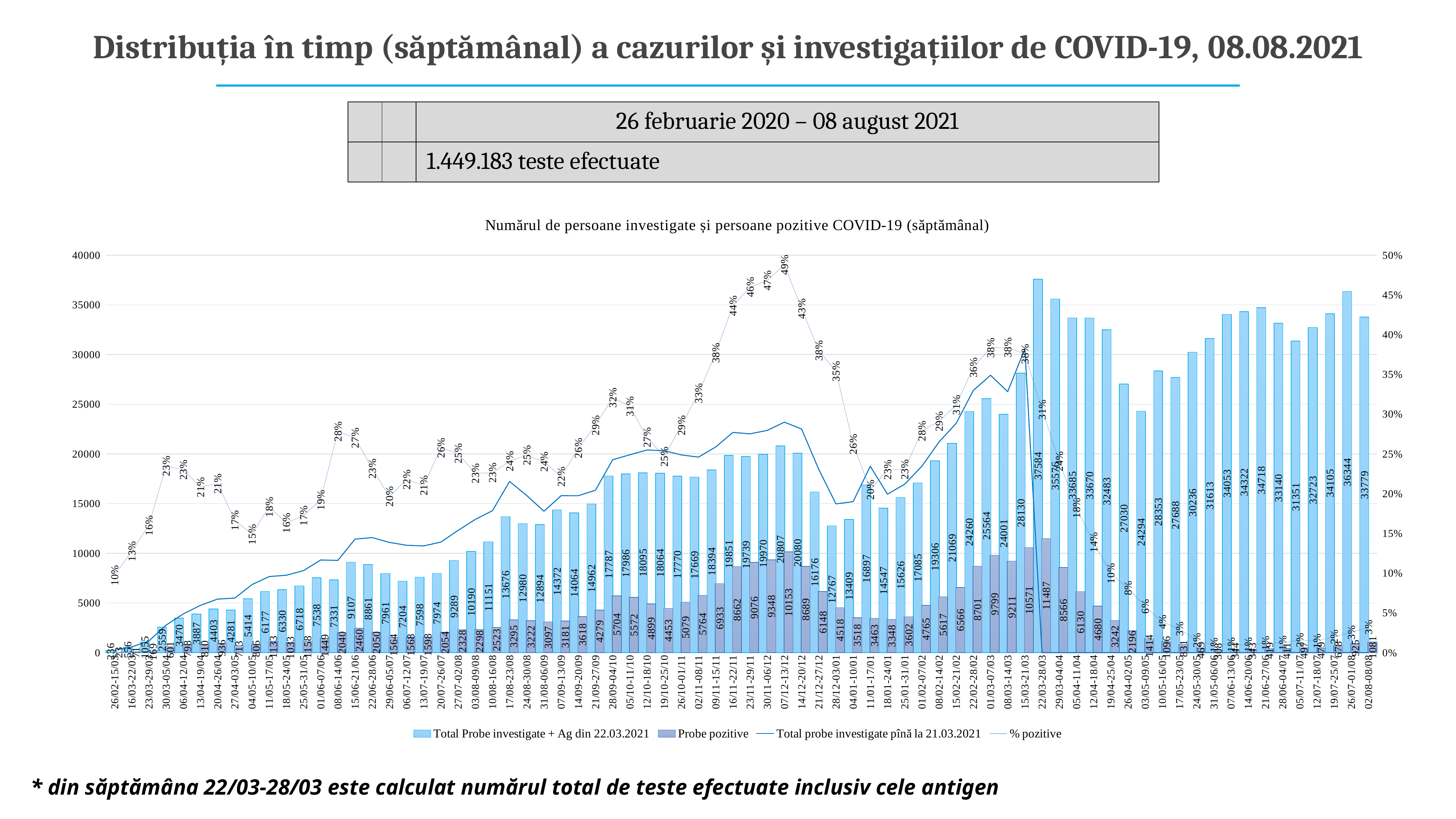
What is the highest value of '% pozitive' shown on the chart? 49% Which week has the highest total number of probes investigated? 22/03-28/03 What is the difference between the total probes investigated in the week 22/03-28/03 and in the week 02/08-08/08? 3805 What kind of chart is shown on the slide? bar and line chart How many series does the legend list? 4 What is the value of 'Probe pozitive' for the week 02/08-08/08? 1081 Which week has a larger total of probes investigated: 26/07-01/08 or 02/08-08/08? 26/07-01/08 What is the value of 'Total Probe investigate + Ag din 22.03.2021' for the week 22/03-28/03? 37584 What is the value of 'Probe pozitive' for the week 07/12-13/12? 10153 What is the title of the chart? Numărul de persoane investigate și persoane pozitive COVID-19 (săptămânal) Is the total number of probes investigated in the week 22/03-28/03 greater or less than 35000? greater What is the value of 'Total Probe investigate + Ag din 22.03.2021' for the week 26/07-01/08? 36344